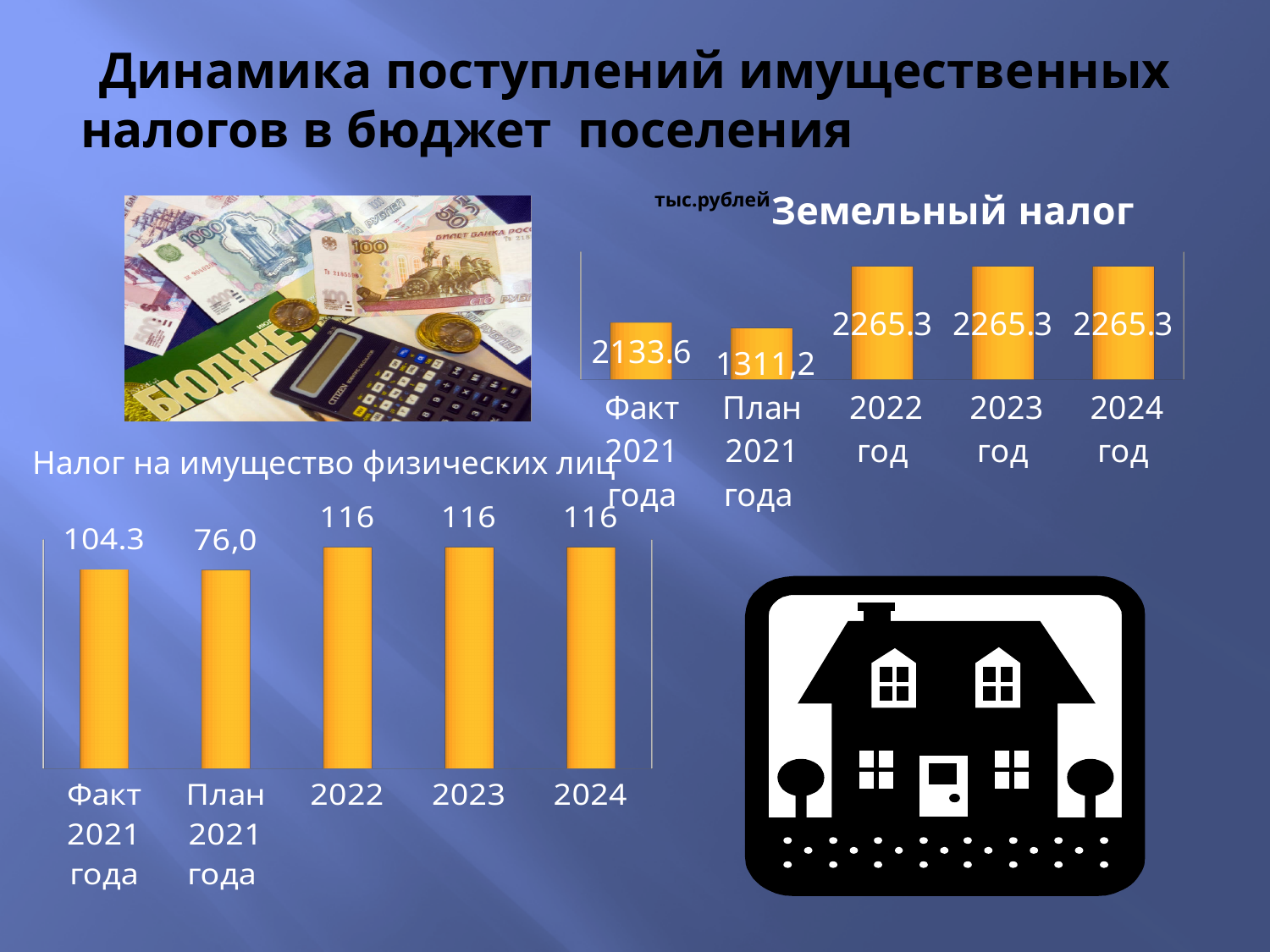
In the 'Земельный налог' chart, what is the value for '2023 год'? 2265.3 In the 'Налог на имущество физических лиц' chart, what is the value for 'Факт 2021 года'? 104.3 In the 'Земельный налог' chart, which category has the lowest value? План 2021 года In the 'Земельный налог' chart, what is the value for 'План 2021 года'? 1311,2 In the 'Земельный налог' chart, what is the difference between 'Факт 2021 года' and 'План 2021 года'? 822.4 In the 'Налог на имущество физических лиц' chart, which is larger: 'Факт 2021 года' or 'План 2021 года'? Факт 2021 года What type of chart is the 'Налог на имущество физических лиц' chart? Bar chart In the 'Земельный налог' chart, how many categories are shown? 5 In the 'Налог на имущество физических лиц' chart, what is the value for 2024? 116 In the 'Налог на имущество физических лиц' chart, what is the value for 'План 2021 года'? 76,0 In the 'Земельный налог' chart, what is the value for 'Факт 2021 года'? 2133.6 In the 'Налог на имущество физических лиц' chart, what is the difference between the 2022 value and the 'Факт 2021 года' value? 11.7